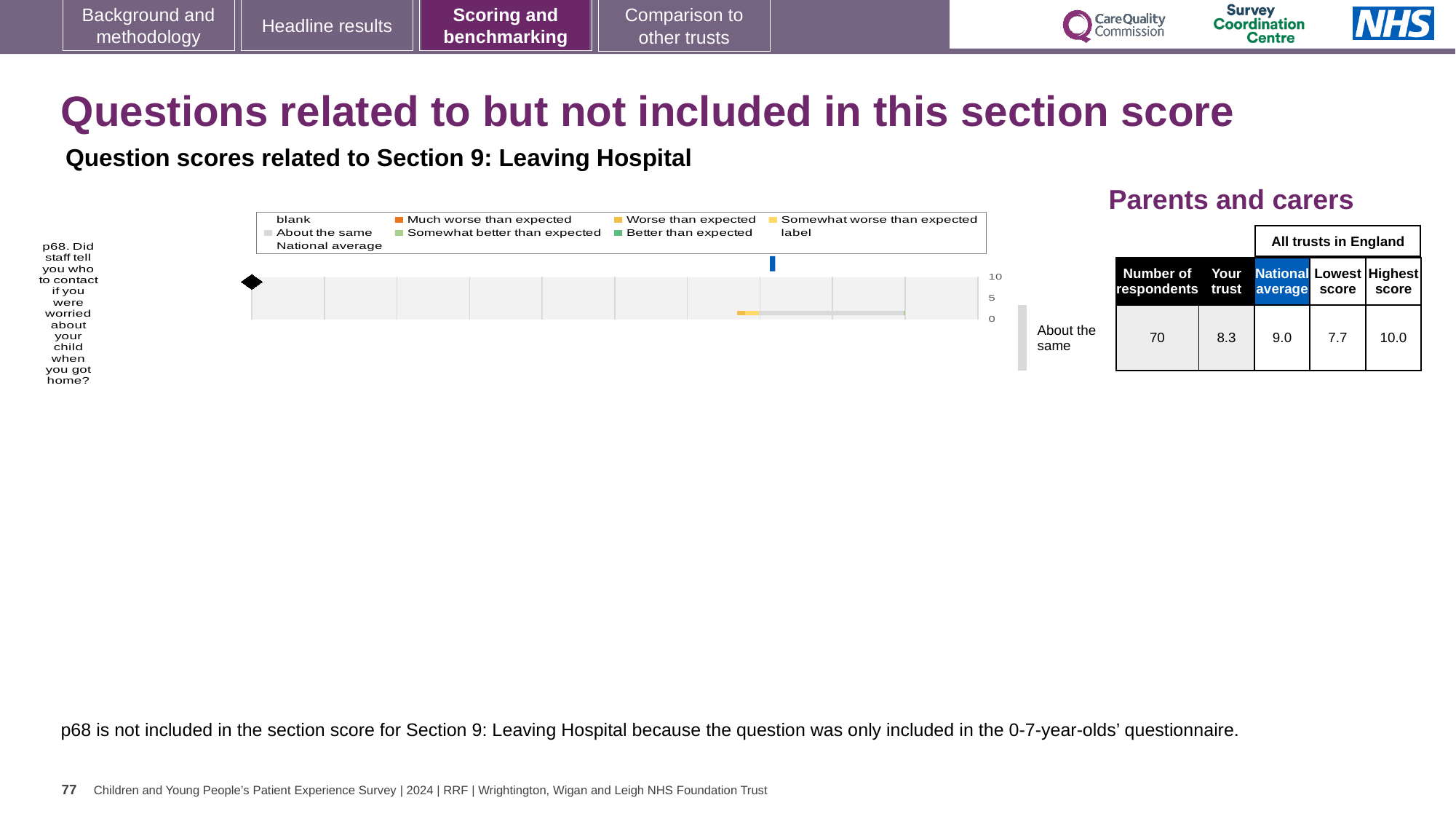
Which is larger for p68, the trust's score or the national average? National average What is the difference between the national average and the trust's score for p68? 0.7 What does the blue marker in the chart legend represent? National average What is the highest score among all trusts in England for p68? 10.0 What is the national average score for p68? 9.0 Is the trust's score for p68 greater or less than 5 on the chart axis? greater What is the lowest score among all trusts in England for p68? 7.7 How many respondents answered p68? 70 What is the 'Your trust' score for p68? 8.3 What kind of chart is used to show the p68 question score? bar chart How many questions are plotted in the chart? 1 What is the highest value shown on the chart's score axis? 10